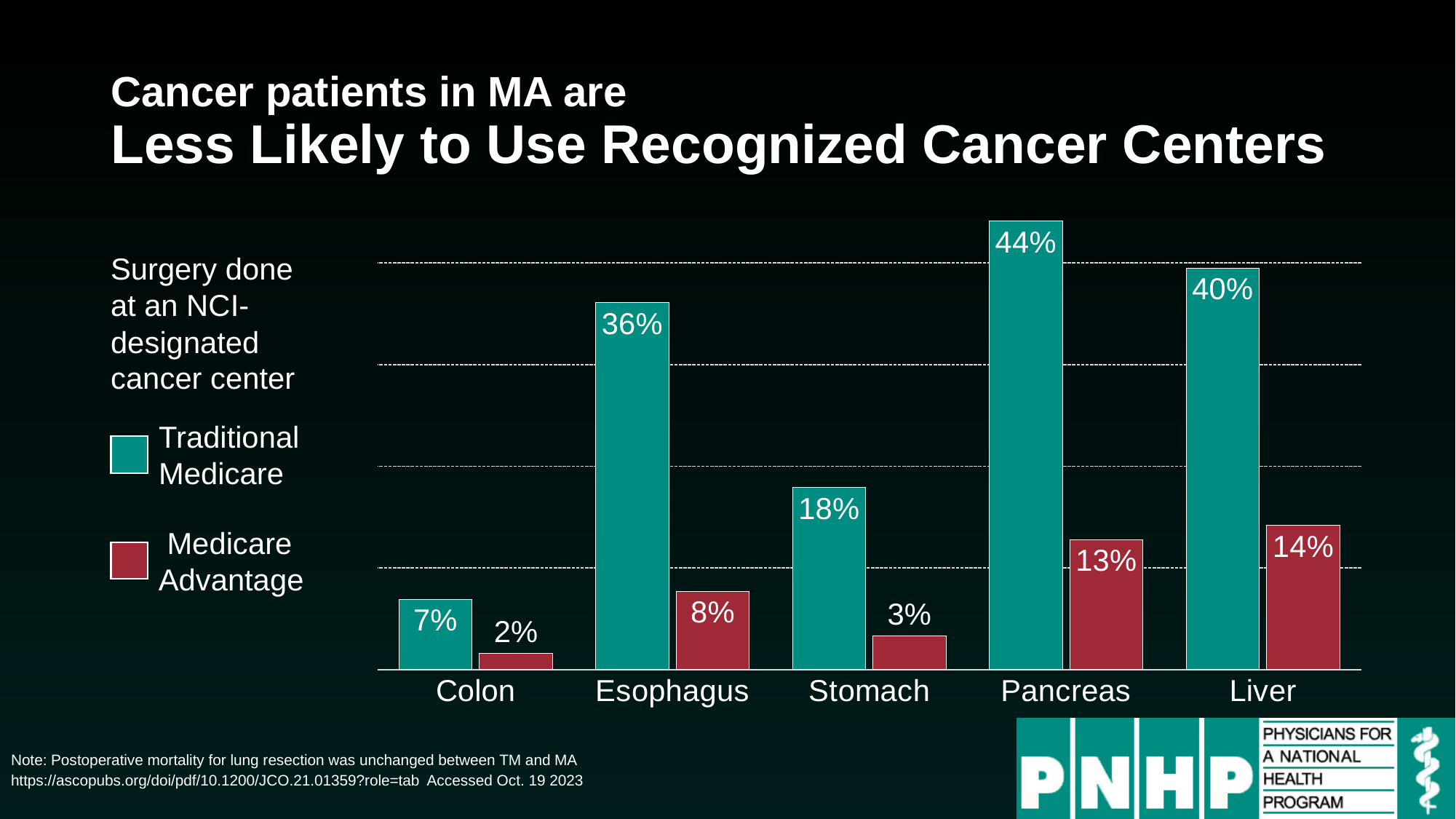
What is the Medicare Advantage value for Stomach? 3% Which cancer type has the highest Traditional Medicare value? Pancreas What percentage of Traditional Medicare pancreas cancer patients had surgery at an NCI-designated cancer center? 44% Which cancer type has the lowest Medicare Advantage value? Colon What is the Traditional Medicare value for Esophagus? 36% What is the difference between the Traditional Medicare and Medicare Advantage values for Liver? 26% What is the difference between the Traditional Medicare values for Pancreas and Esophagus? 8% Which is larger: the Medicare Advantage value for Pancreas or the Medicare Advantage value for Esophagus? Pancreas What kind of chart is shown on the slide? Bar chart How many cancer types are shown on the x axis? 5 How many series does the legend list? 2 What is the Medicare Advantage value for Liver? 14%